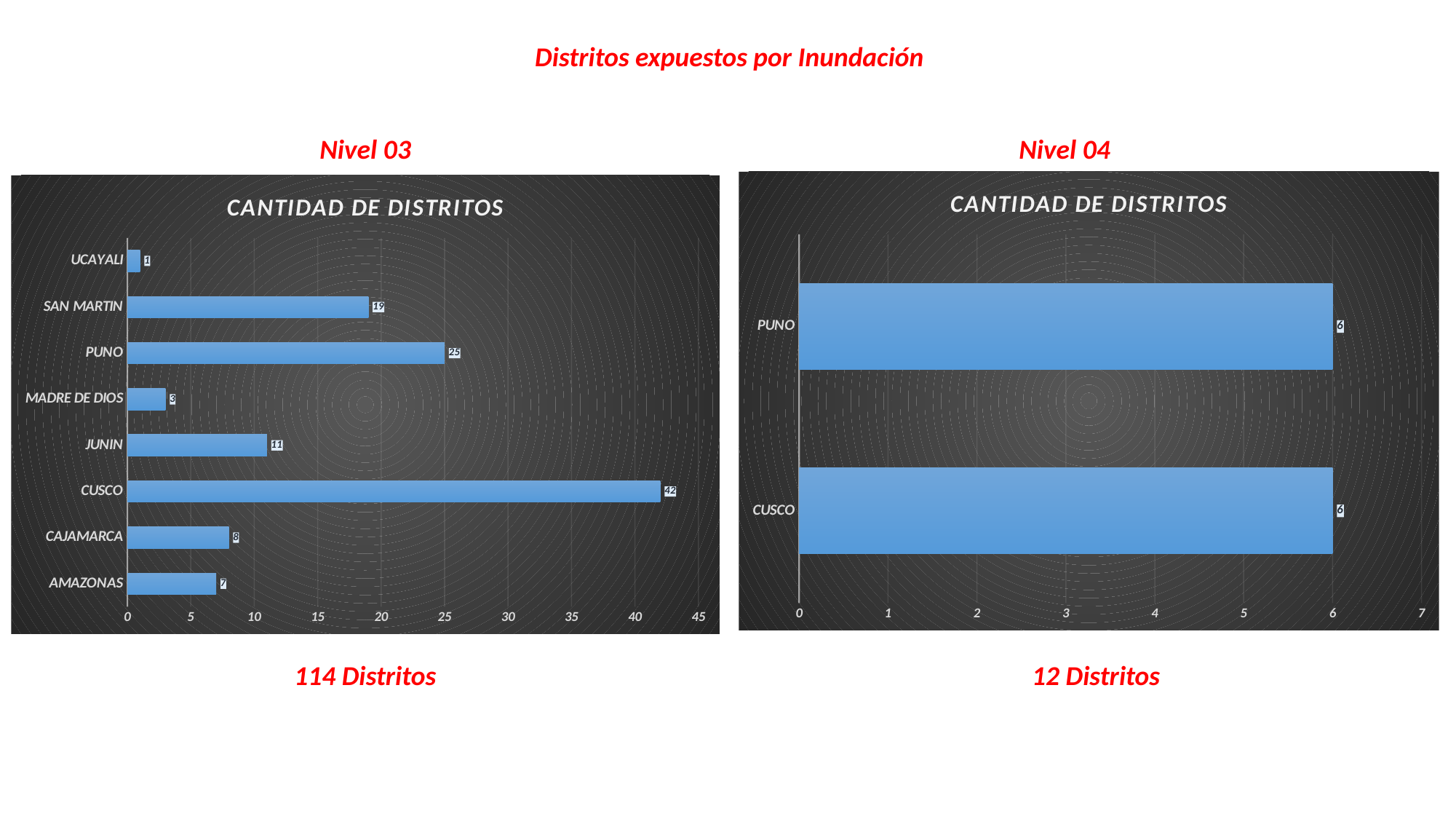
In the Nivel 03 chart, which category has the lowest value? UCAYALI In the Nivel 03 chart, what is the difference between the values for PUNO and JUNIN? 14 In the Nivel 03 chart, what is the value for CUSCO? 42 In the Nivel 03 chart, what is the value for MADRE DE DIOS? 3 In the Nivel 03 chart, which is larger, the value for CAJAMARCA or the value for AMAZONAS? CAJAMARCA In the Nivel 04 chart, what is the value for PUNO? 6 What is the title shown inside the Nivel 03 chart? CANTIDAD DE DISTRITOS In the Nivel 03 chart, which category has the highest value? CUSCO In the Nivel 04 chart, how many categories are shown? 2 In the Nivel 03 chart, how many categories are shown? 8 What kind of chart is the Nivel 04 chart? Bar chart In the Nivel 03 chart, what is the value for SAN MARTIN? 19